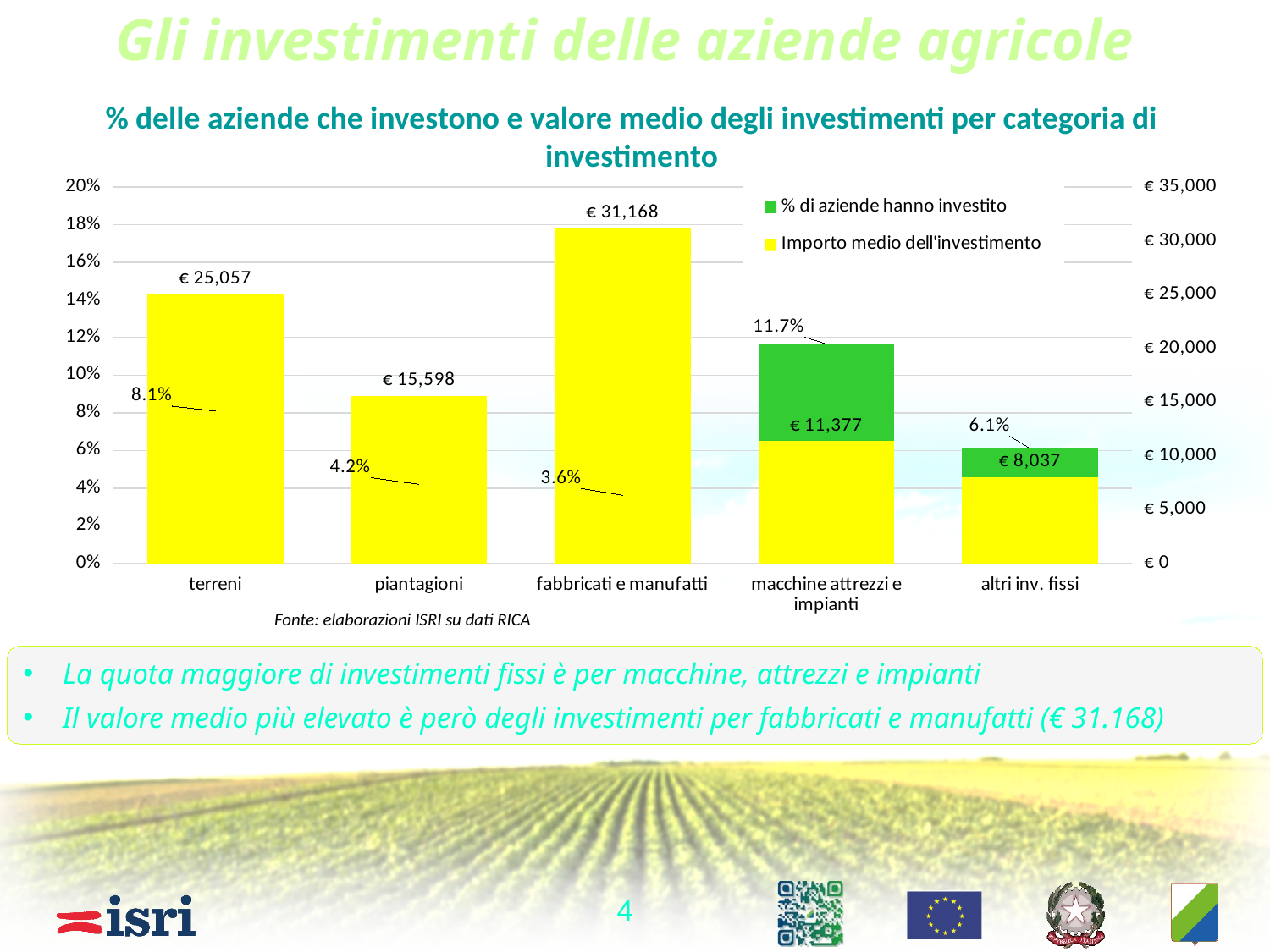
Which category has the lowest average investment amount? altri inv. fissi What is the average investment amount (Importo medio dell'investimento) for fabbricati e manufatti? € 31,168 Which category has the highest average investment amount? fabbricati e manufatti What is the difference between the average investment amount for terreni and for piantagioni? € 9,459 How many investment categories are shown on the x axis? 5 What percentage of farms invested (% di aziende hanno investito) in macchine attrezzi e impianti? 11.7% How many series does the legend list? 2 What type of chart is shown on the slide? bar chart Which category has the lowest percentage of farms that invested? fabbricati e manufatti What is the average investment amount for terreni? € 25,057 What percentage of farms invested in piantagioni? 4.2% Which has a higher percentage of farms investing: terreni or altri inv. fissi? terreni